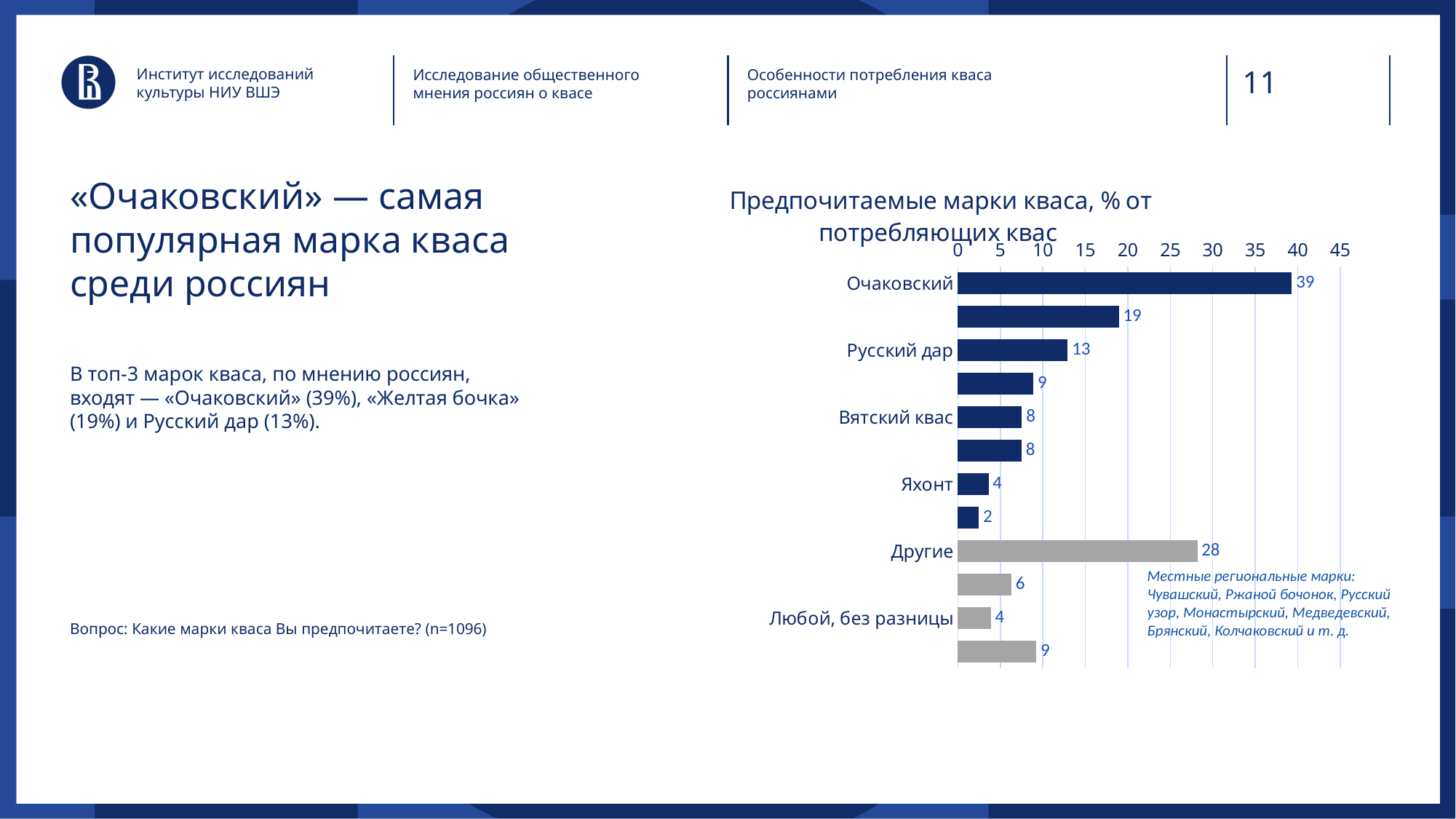
Which is larger, the value for Другие or the value for Русский дар? Другие What is the value for Очаковский? 39 What is the value for Другие? 28 What type of chart is shown on the slide? bar chart What is the difference between the values for Очаковский and Русский дар? 26 What is the value for Любой, без разницы? 4 What is the title of the chart? Предпочитаемые марки кваса, % от потребляющих квас Which category has the highest value in the chart? Очаковский What is the value for Яхонт? 4 What is the value for Вятский квас? 8 How many bars are plotted in the chart? 12 What is the value for Русский дар? 13